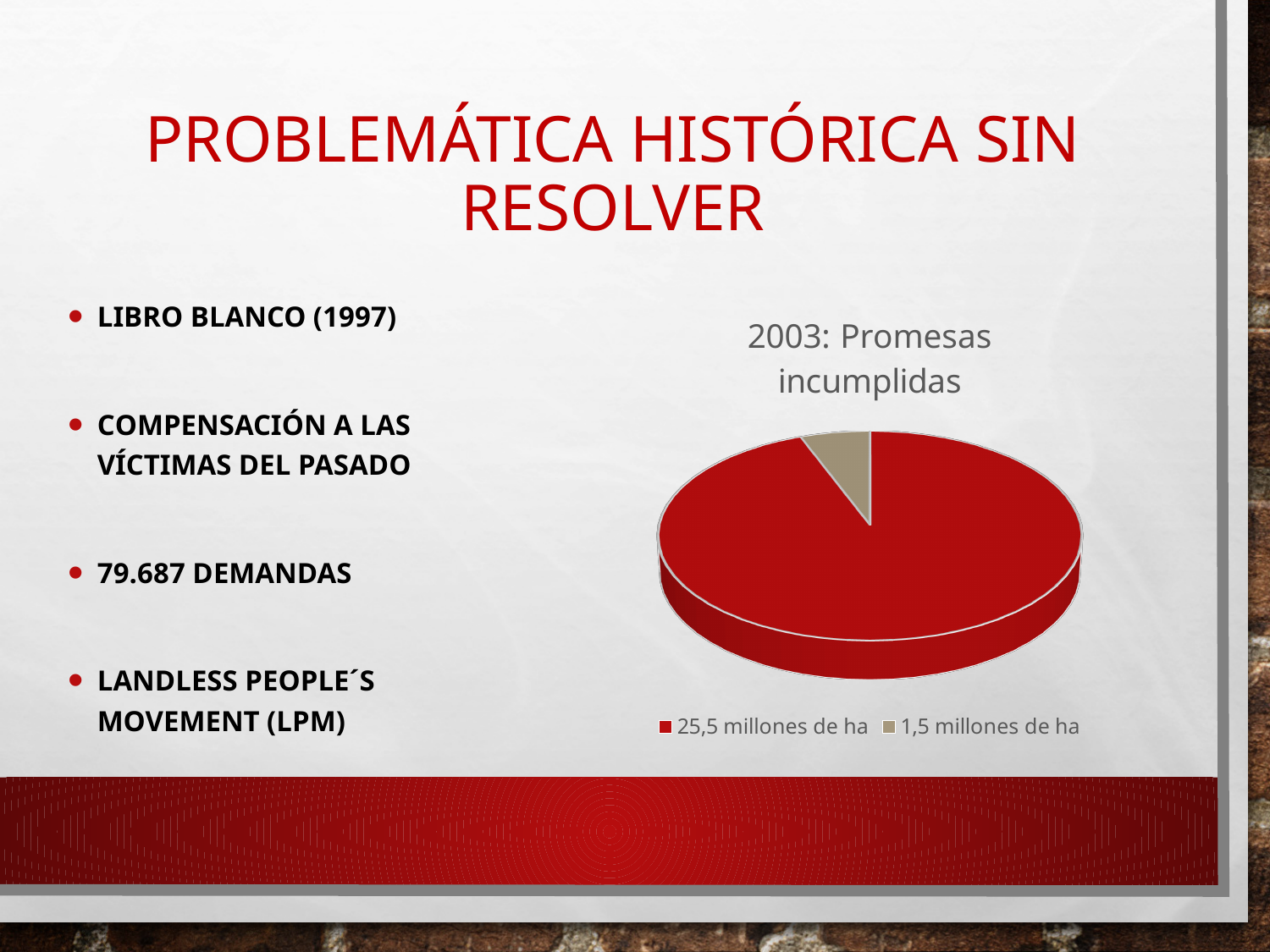
Which legend entry of the pie chart is shown in red? 25,5 millones de ha How many entries does the pie chart's legend list? 2 Which slice is larger in the pie chart, "25,5 millones de ha" or "1,5 millones de ha"? 25,5 millones de ha What is the title of the pie chart? 2003: Promesas incumplidas Which legend entry corresponds to the smallest slice of the pie chart? 1,5 millones de ha How many slices does the pie chart have? 2 Which legend entry corresponds to the largest slice of the pie chart? 25,5 millones de ha What kind of chart is shown on the slide? pie chart